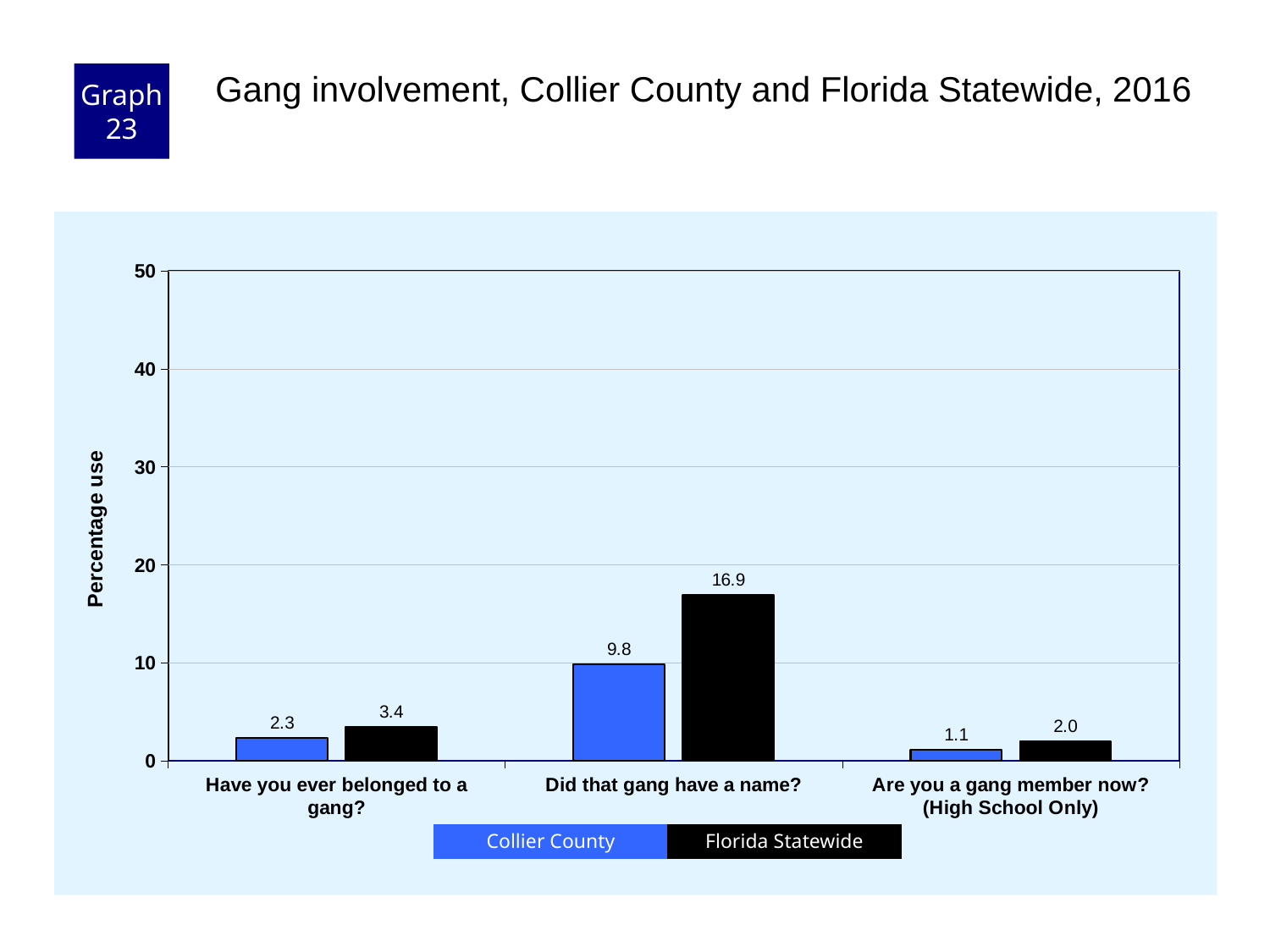
What kind of chart is shown on the slide? Bar chart Is the Florida Statewide value for "Did that gang have a name?" greater or less than 20? less How many series does the legend list? 2 Which category has the lowest Collier County value? Are you a gang member now? (High School Only) What is the Florida Statewide value for "Have you ever belonged to a gang?"? 3.4 How many categories are shown on the x axis? 3 What is the Collier County value for "Are you a gang member now? (High School Only)"? 1.1 What is the difference between the Florida Statewide and Collier County values for "Did that gang have a name?"? 7.1 For "Have you ever belonged to a gang?", which is larger: Collier County or Florida Statewide? Florida Statewide What is the Collier County value for "Did that gang have a name?"? 9.8 What is the label of the y axis? Percentage use Which category has the highest Florida Statewide value? Did that gang have a name?